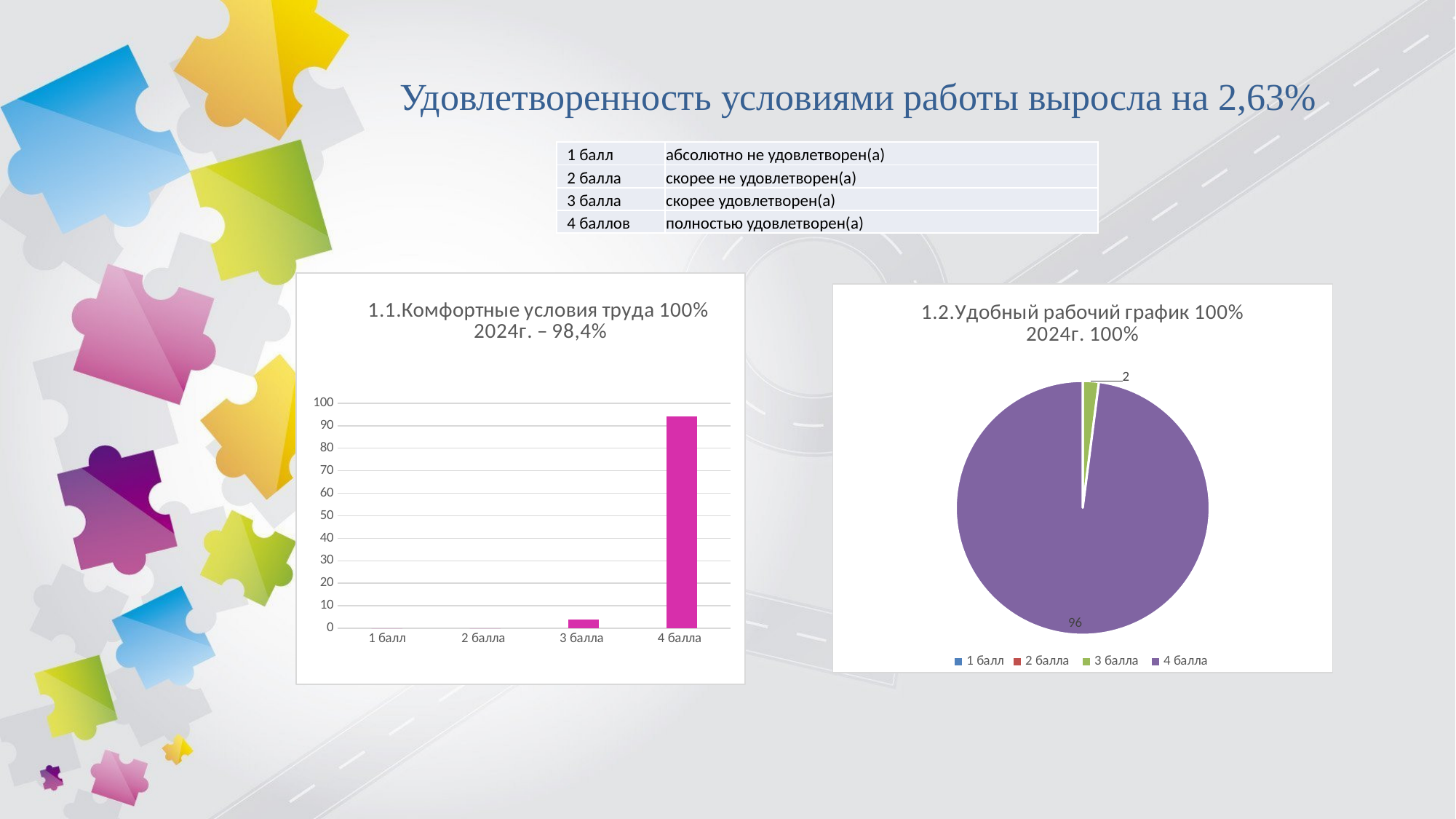
In the bar chart on the left, which is larger: the value for 3 балла or the value for 4 балла? 4 балла In the pie chart on the right, what is the value labelled for the 4 балла slice? 96 What is the title of the bar chart on the left? 1.1.Комфортные условия труда 100% 2024г. – 98,4% In the bar chart on the left, which category has the highest value? 4 балла What kind of chart is the chart titled "1.2.Удобный рабочий график"? pie chart In the bar chart on the left, is the value for 3 балла greater or less than 10? less How many entries does the legend of the pie chart on the right list? 4 In the pie chart on the right, what is the value labelled for the 3 балла slice? 2 In the bar chart on the left, how many categories are shown on the x axis? 4 In the bar chart on the left, is the value for 4 балла greater or less than 90? greater In the pie chart on the right, what is the difference between the 4 балла value and the 3 балла value? 94 What kind of chart is the chart titled "1.1.Комфортные условия труда"? bar chart